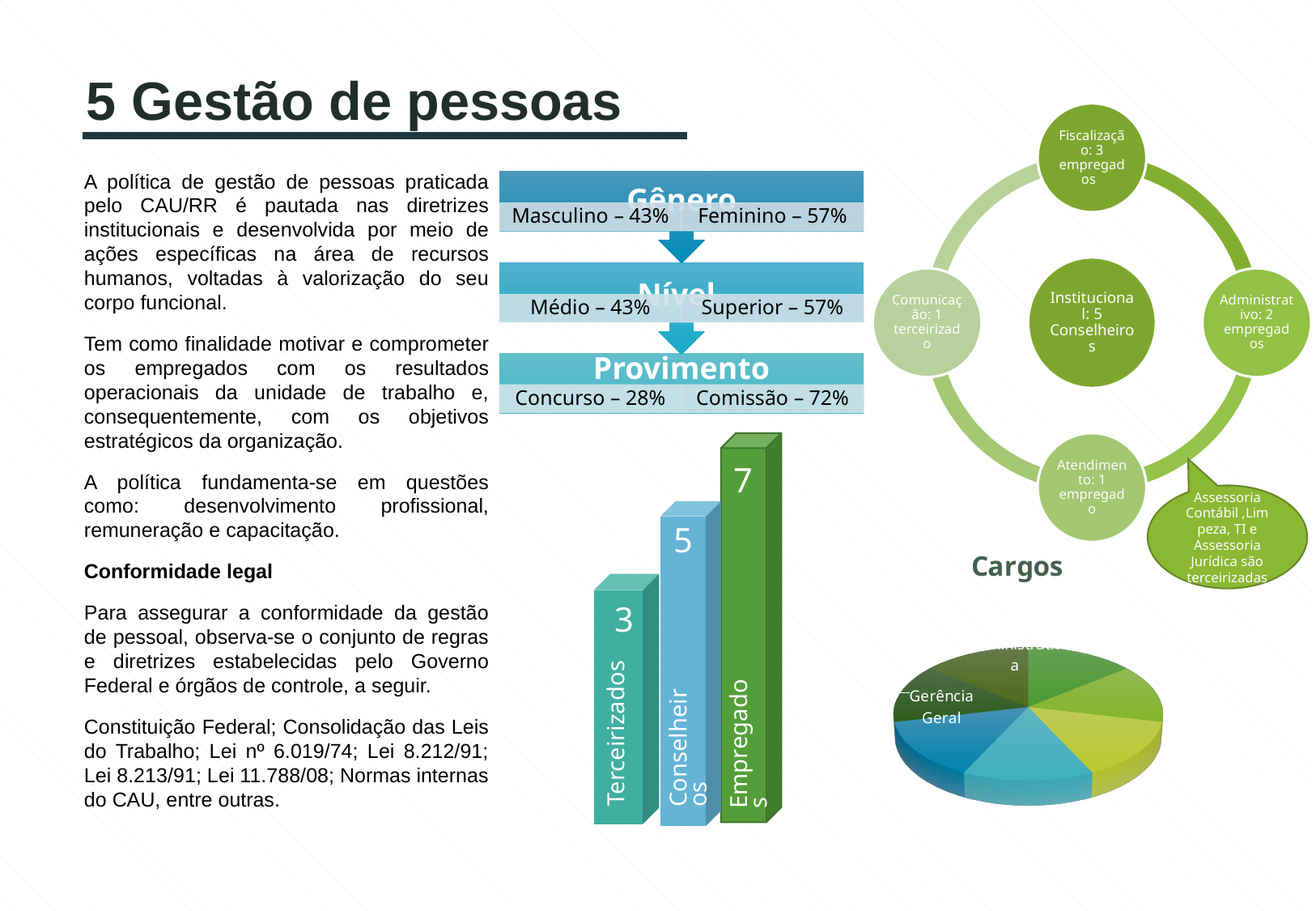
In the bar chart, what is the difference between the values for Empregados and Terceirizados? 4 In the bar chart, which is larger: the value for Conselheiros or the value for Empregados? Empregados What kind of chart is the chart titled Cargos in the lower right of the slide? Pie chart In the bar chart, what is the value for Terceirizados? 3 How many categories does the bar chart show? 3 In the bar chart, what is the value for Conselheiros? 5 In the bar chart, what is the difference between the values for Conselheiros and Terceirizados? 2 What kind of chart is the chart showing Terceirizados, Conselheiros and Empregados? Bar chart In the bar chart, which category has the highest value? Empregados In the bar chart, do the values rise or fall from Terceirizados to Empregados? Rise In the bar chart, which category has the lowest value? Terceirizados In the bar chart, what is the value for Empregados? 7